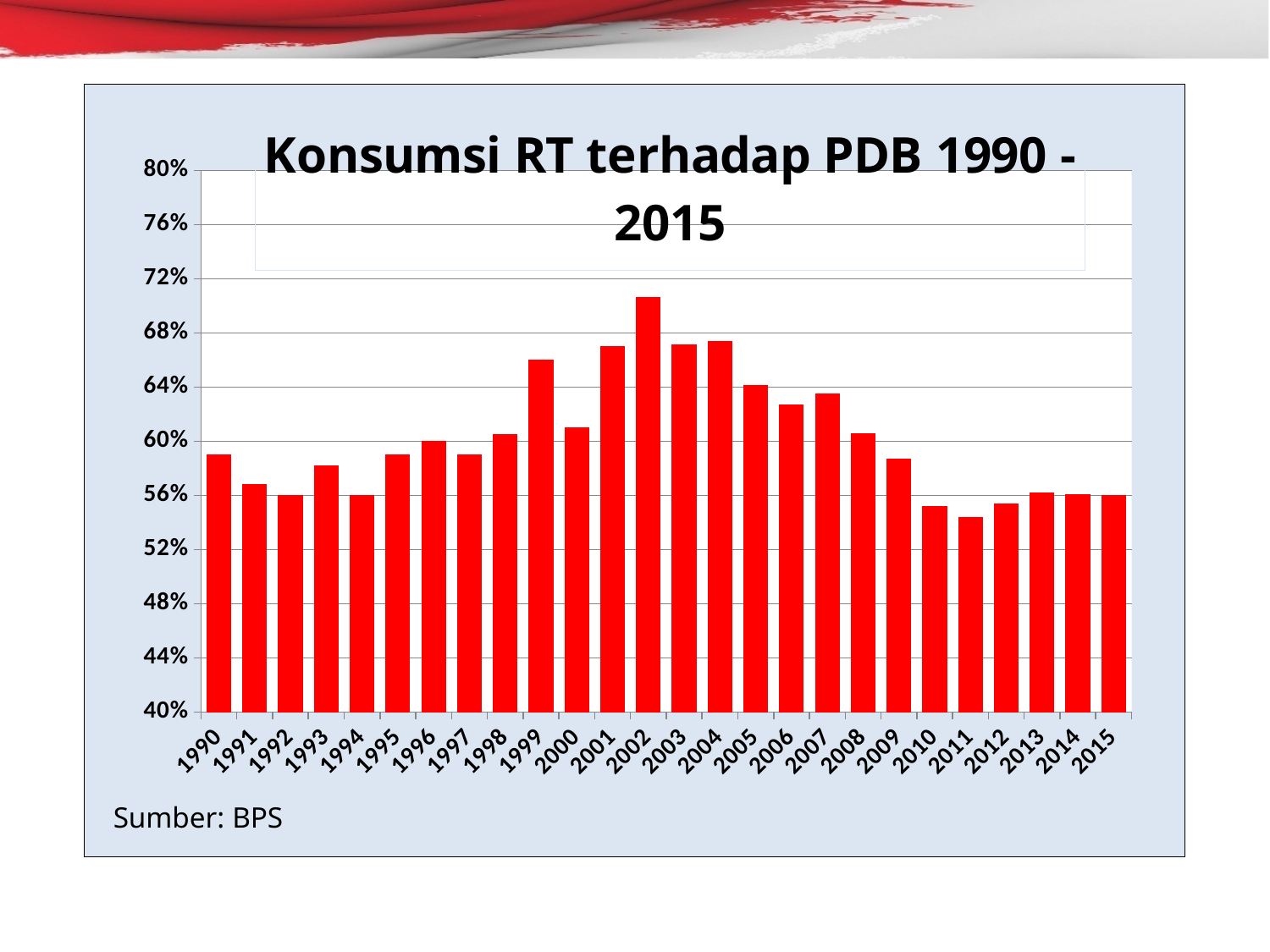
Is the value for 1999 greater or less than 64%? greater Is the value for 2002 greater or less than 68%? greater What is the title of the chart? Konsumsi RT terhadap PDB 1990 - 2015 Is the value for 2009 greater or less than 60%? less Which year has the larger value, 1999 or 2000? 1999 Do the values rise or fall from 2002 to 2011? fall Which year has the lowest value in the chart? 2011 What kind of chart is shown on the slide? bar chart Which year has the highest value in the chart? 2002 What source is cited below the chart? BPS How many years (bars) are plotted in the chart? 26